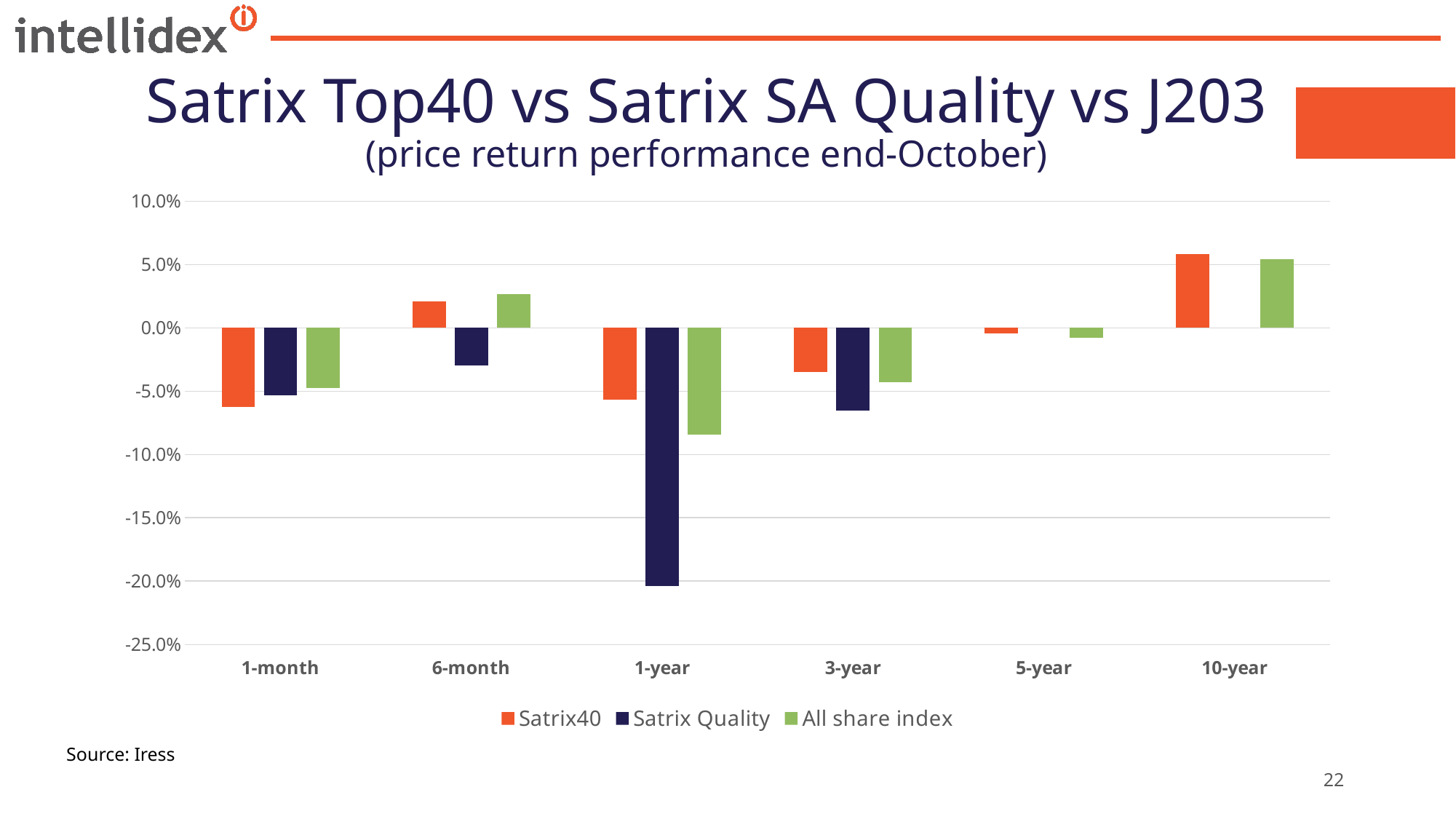
What kind of chart is shown on the slide? Bar chart Is the value for Satrix40 at 10-year greater or less than 5.0%? greater How many series does the legend list? 3 At 6-month, which is larger: Satrix40 or Satrix Quality? Satrix40 In which period does Satrix40 have its highest value? 10-year Is the value for All share index at 1-year greater or less than -5.0%? less How many time periods are shown on the x axis? 6 Is the value for Satrix Quality at 1-year greater or less than -15.0%? less At 1-year, which is larger: Satrix40 or All share index? Satrix40 Which series and period has the lowest value on the chart? Satrix Quality, 1-year What is the source cited for the chart? Iress At 3-year, which is larger: Satrix Quality or All share index? All share index